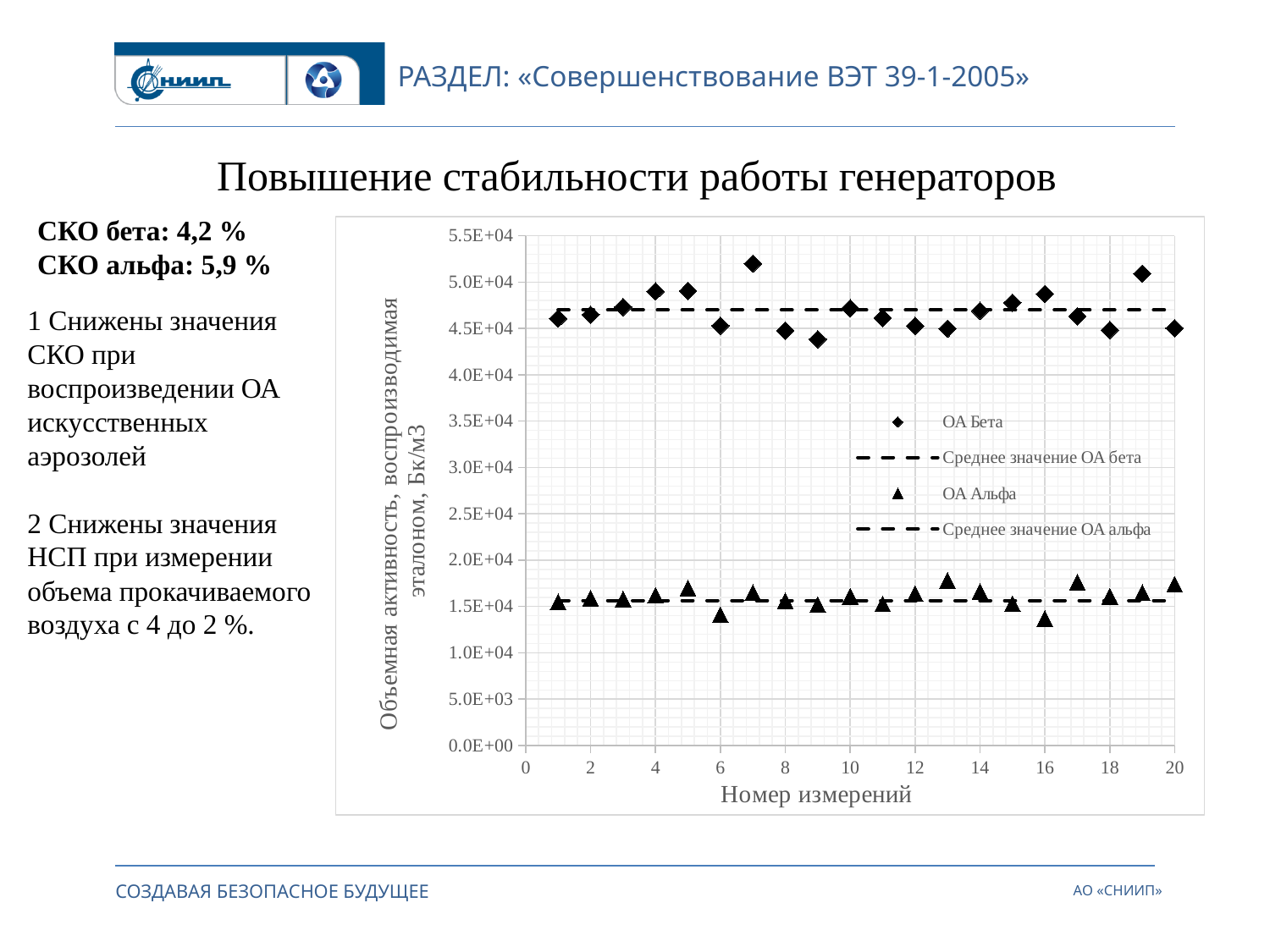
How many measurement points are plotted for the ОА Альфа series? 20 Which series has higher values overall, ОА Бета or ОА Альфа? ОА Бета What kind of chart is shown on the slide? scatter chart Is the dashed line for Среднее значение ОА бета above or below 4.5E+04? above Is the ОА Альфа value at measurement 16 greater or less than 1.5E+04? less How many entries does the chart legend list? 4 What is the label of the x axis of the chart? Номер измерений Is the ОА Альфа value at measurement 13 greater or less than 1.5E+04? greater What unit is given in the y-axis label of the chart? Бк/м3 How many measurement points are plotted for the ОА Бета series? 20